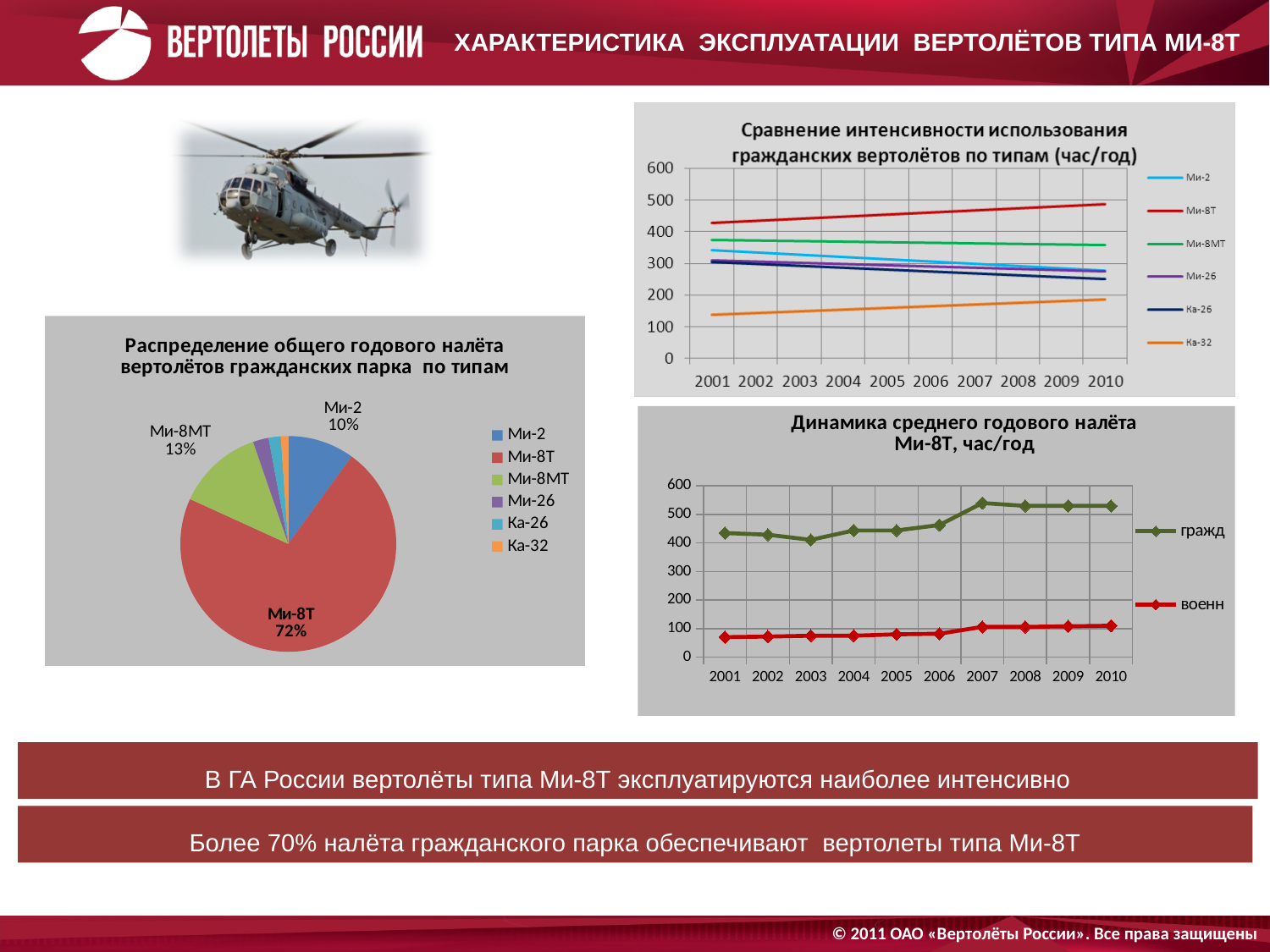
In the chart 'Сравнение интенсивности использования гражданских вертолётов по типам (час/год)', which helicopter type has the lowest line throughout the period? Ка-32 In the pie chart 'Распределение общего годового налёта вертолётов гражданских парка по типам', how many helicopter types does the legend list? 6 In the pie chart 'Распределение общего годового налёта вертолётов гражданских парка по типам', what is the difference in percentage points between the Ми-8Т and Ми-8МТ shares? 59 In the pie chart 'Распределение общего годового налёта вертолётов гражданских парка по типам', what share does Ми-8МТ have? 13% In the chart 'Сравнение интенсивности использования гражданских вертолётов по типам (час/год)', does the Ми-2 line rise or fall from 2001 to 2010? fall In the pie chart 'Распределение общего годового налёта вертолётов гражданских парка по типам', which helicopter type has the largest slice? Ми-8Т In the chart 'Сравнение интенсивности использования гражданских вертолётов по типам (час/год)', how many series does the legend list? 6 In the pie chart 'Распределение общего годового налёта вертолётов гражданских парка по типам', what share does Ми-8Т have? 72% In the chart 'Динамика среднего годового налёта Ми-8Т, час/год', is the value for гражд in 2007 greater or less than 500? greater In the chart 'Динамика среднего годового налёта Ми-8Т, час/год', what kind of chart is it? line chart In the chart 'Сравнение интенсивности использования гражданских вертолётов по типам (час/год)', which helicopter type has the highest line throughout the period? Ми-8Т In the pie chart 'Распределение общего годового налёта вертолётов гражданских парка по типам', what share does Ми-2 have? 10%